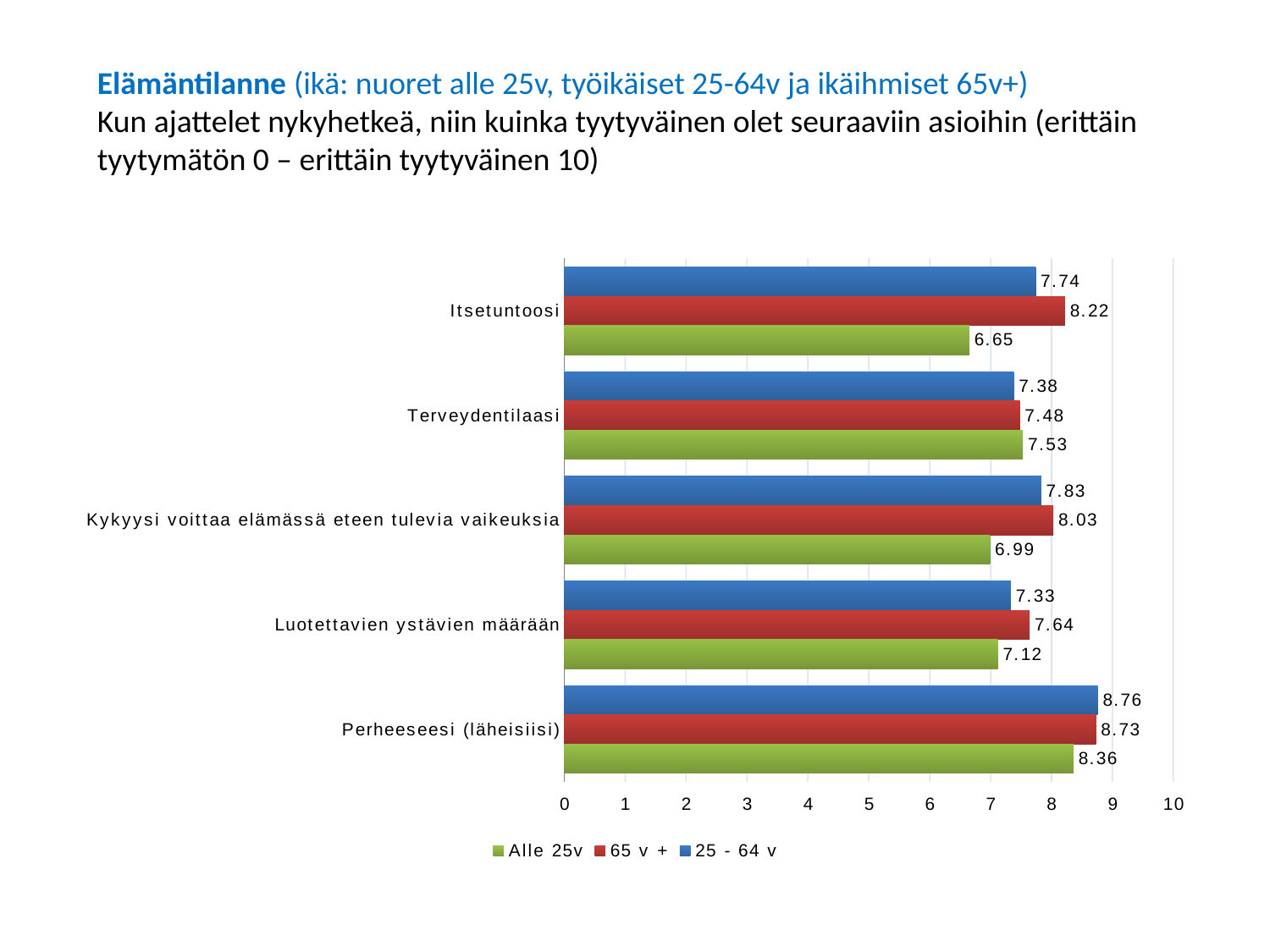
What is the value for '65 v +' in the category 'Perheeseesi (läheisiisi)'? 8.73 Which colour represents the '65 v +' series in the chart? red Is the value for 'Alle 25v' in the category 'Perheeseesi (läheisiisi)' greater or less than 8? greater What is the value for 'Alle 25v' in the category 'Itsetuntoosi'? 6.65 What is the value for '25 - 64 v' in the category 'Luotettavien ystävien määrään'? 7.33 In the category 'Kykyysi voittaa elämässä eteen tulevia vaikeuksia', which is larger: the value for '65 v +' or for 'Alle 25v'? 65 v + Which category has the highest value for the '25 - 64 v' series? Perheeseesi (läheisiisi) How many categories are shown on the chart? 5 Which category has the lowest value for the 'Alle 25v' series? Itsetuntoosi What is the difference between the '65 v +' and 'Alle 25v' values in the category 'Itsetuntoosi'? 1.57 How many series does the legend list? 3 What type of chart is shown on the slide? bar chart